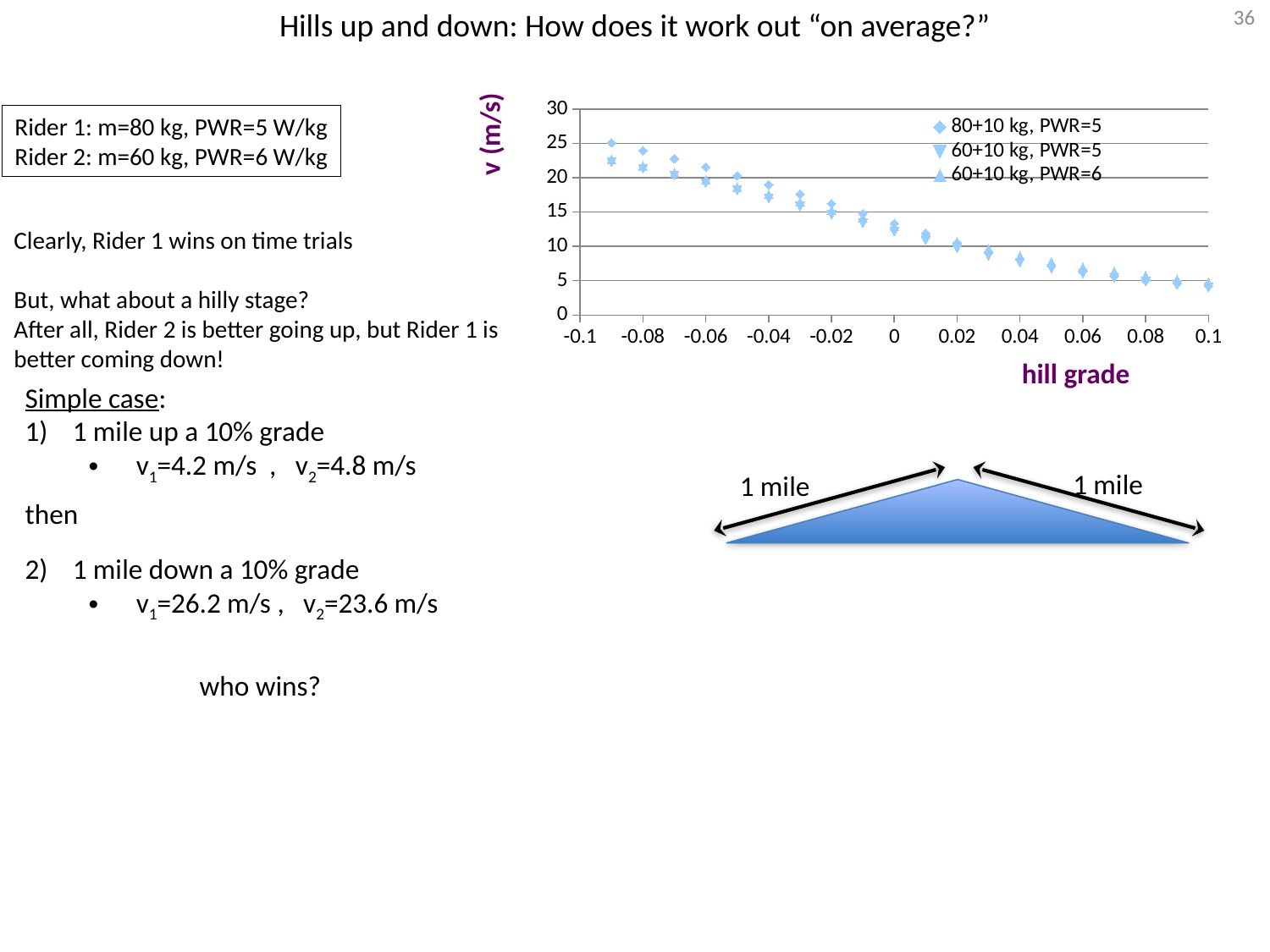
As hill grade increases from -0.1 to 0.1, do the plotted speeds rise or fall? fall What is the label of the chart's y axis? v (m/s) How many series does the chart legend list? 3 Which series has the highest value at the leftmost plotted hill grade? 80+10 kg, PWR=5 Is the value for the 80+10 kg, PWR=5 series at hill grade -0.08 greater or less than 20? greater Is the value for the 60+10 kg, PWR=5 series at hill grade 0 greater or less than 15? less Is the value for the 80+10 kg, PWR=5 series at hill grade 0.1 greater or less than 5? less What kind of chart is shown on the slide? scatter chart At hill grade -0.08, which series has the larger value: 80+10 kg, PWR=5 or 60+10 kg, PWR=5? 80+10 kg, PWR=5 What is the maximum value shown on the chart's y axis? 30 What is the label of the chart's x axis? hill grade